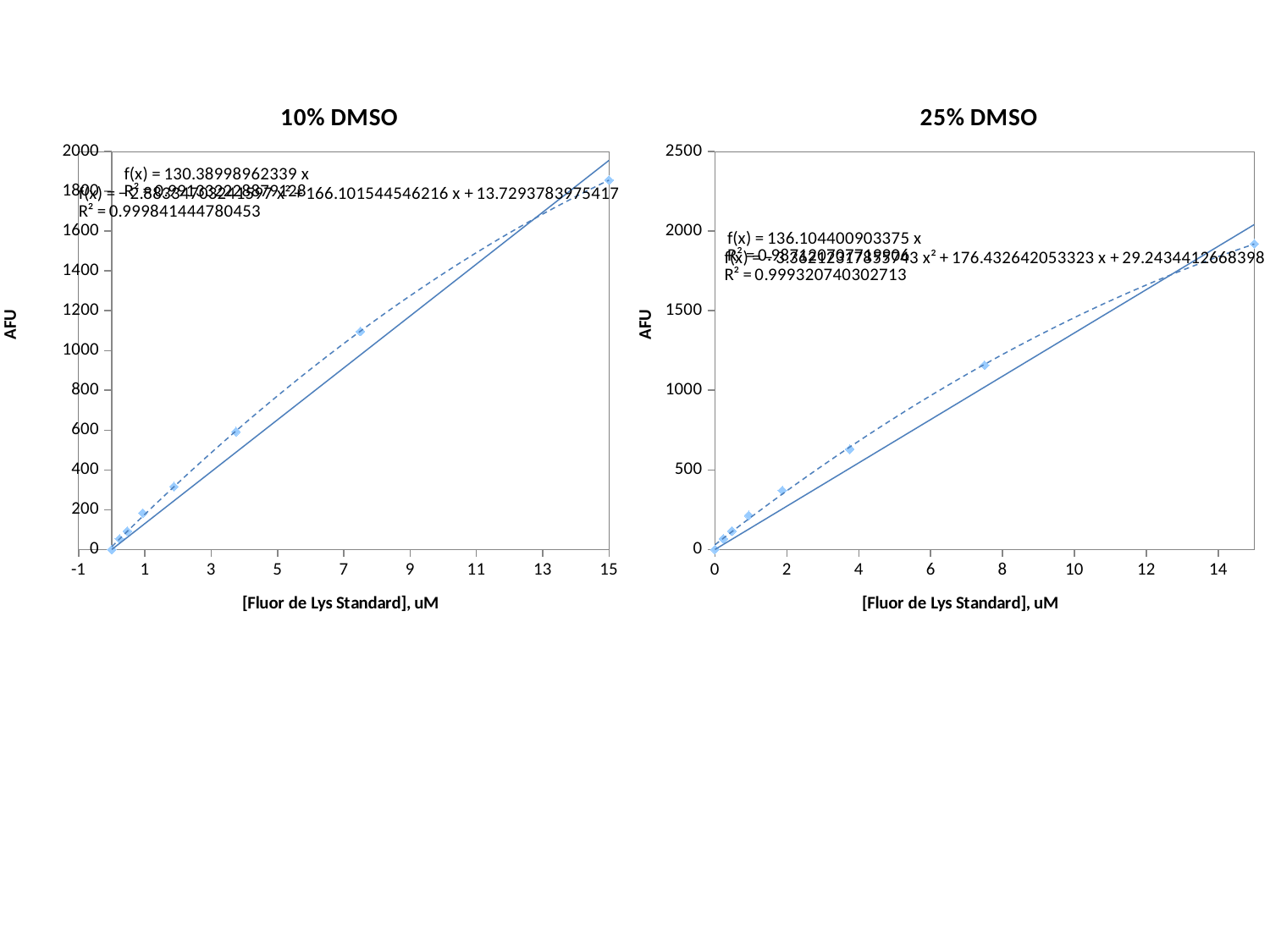
In the "25% DMSO" chart, is the AFU value at 15 uM greater or less than 1500? greater What is the label of the x axis on the "10% DMSO" chart? [Fluor de Lys Standard], uM What kind of chart is the "10% DMSO" chart? Scatter chart What is the slope of the linear fit f(x) shown on the "25% DMSO" chart? 136.104400903375 In the "10% DMSO" chart, is the AFU value at 15 uM greater or less than 1800? greater In the "25% DMSO" chart, is the AFU value at about 4 uM greater or less than 500? greater In the "10% DMSO" chart, at which x-axis concentration is the AFU value lowest? 0 uM In the "25% DMSO" chart, at which x-axis concentration is the AFU value highest? 15 uM What is the label of the y axis on the "25% DMSO" chart? AFU In the "10% DMSO" chart, do the AFU values rise or fall as the Fluor de Lys Standard concentration increases? Rise